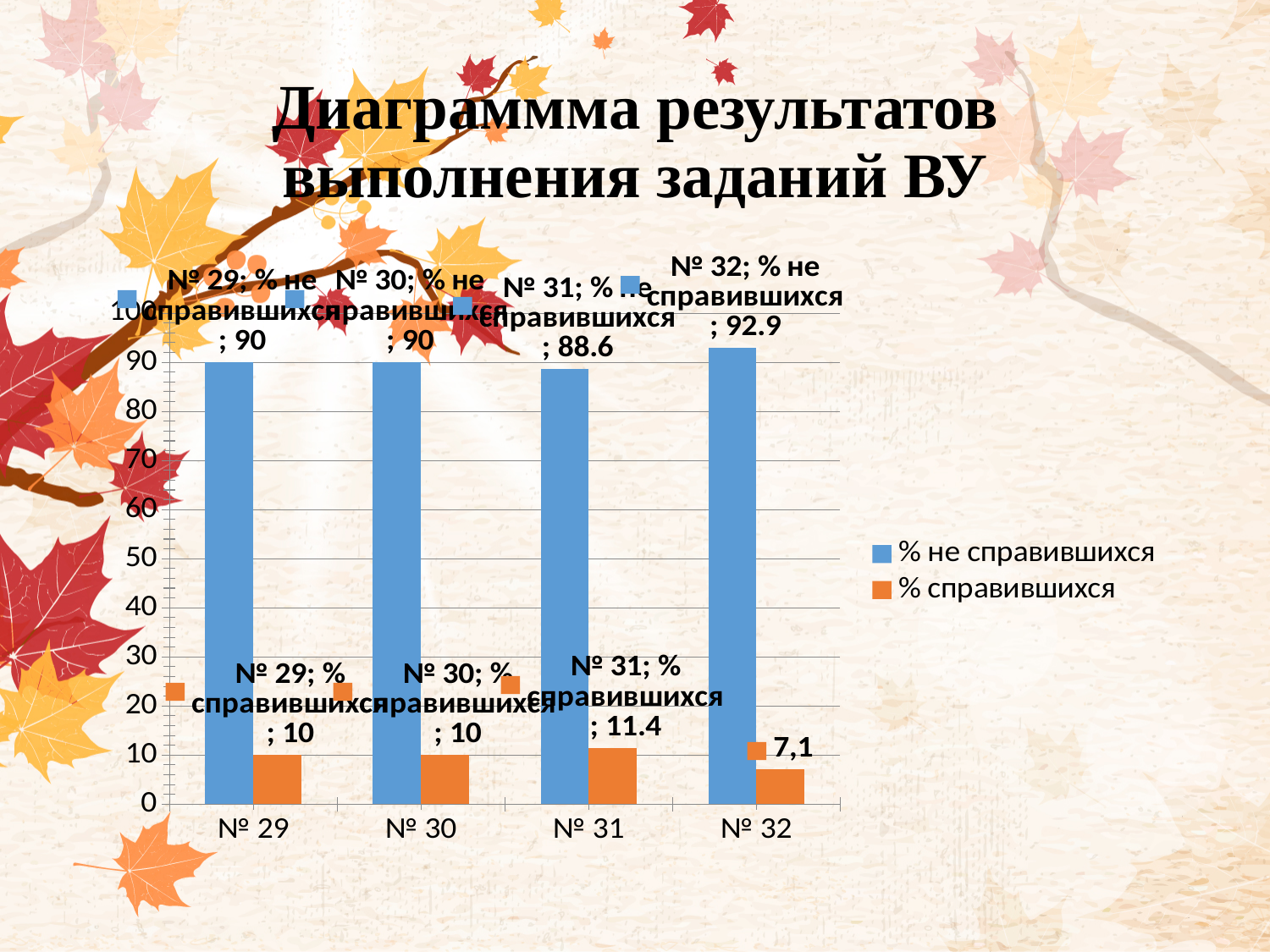
What is the difference between "% не справившихся" for № 32 and for № 31? 4.3 Which series is shown in blue? % не справившихся Which category has the highest value for "% не справившихся"? № 32 How many categories are shown on the x axis? 4 Which category has the lowest value for "% справившихся"? № 32 What is the value of "% справившихся" for № 29? 10 What is the value of "% справившихся" for № 31? 11.4 What is the value of "% не справившихся" for № 31? 88.6 What is the value of "% справившихся" for № 32? 7,1 What type of chart is shown on the slide? bar chart What is the value of "% не справившихся" for № 32? 92.9 How many series does the legend list? 2